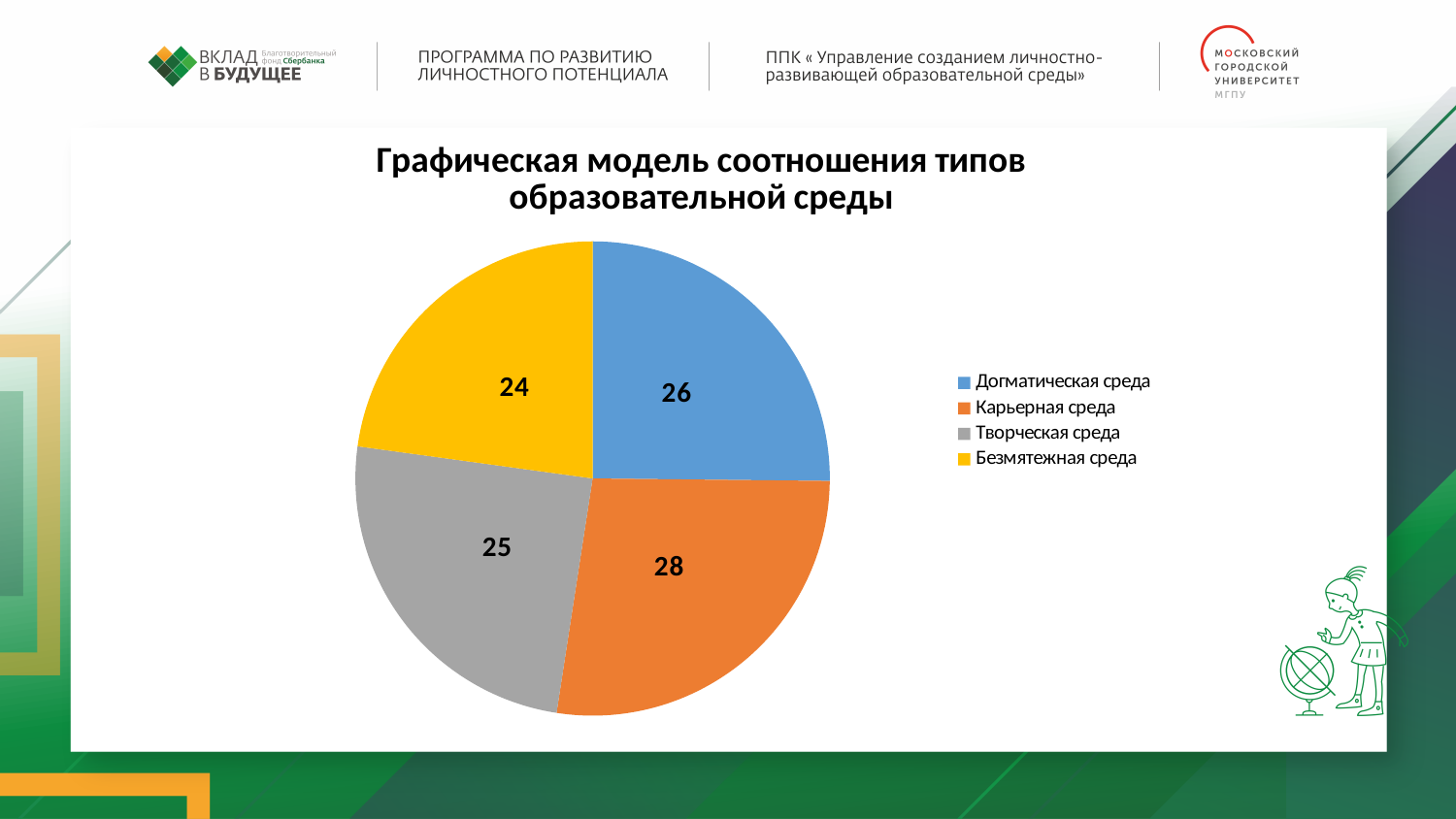
What is the value for Безмятежная среда? 24 What type of chart is shown on the slide? Pie chart What colour is the slice for Творческая среда? Gray Which category has the smallest slice of the pie? Безмятежная среда Which category has the largest slice of the pie? Карьерная среда What is the value for Догматическая среда? 26 What is the title of the chart? Графическая модель соотношения типов образовательной среды How many categories does the pie chart show? 4 What is the value for Творческая среда? 25 What is the difference between the values for Карьерная среда and Безмятежная среда? 4 Which is larger, the value for Догматическая среда or the value for Творческая среда? Догматическая среда What is the value for Карьерная среда? 28